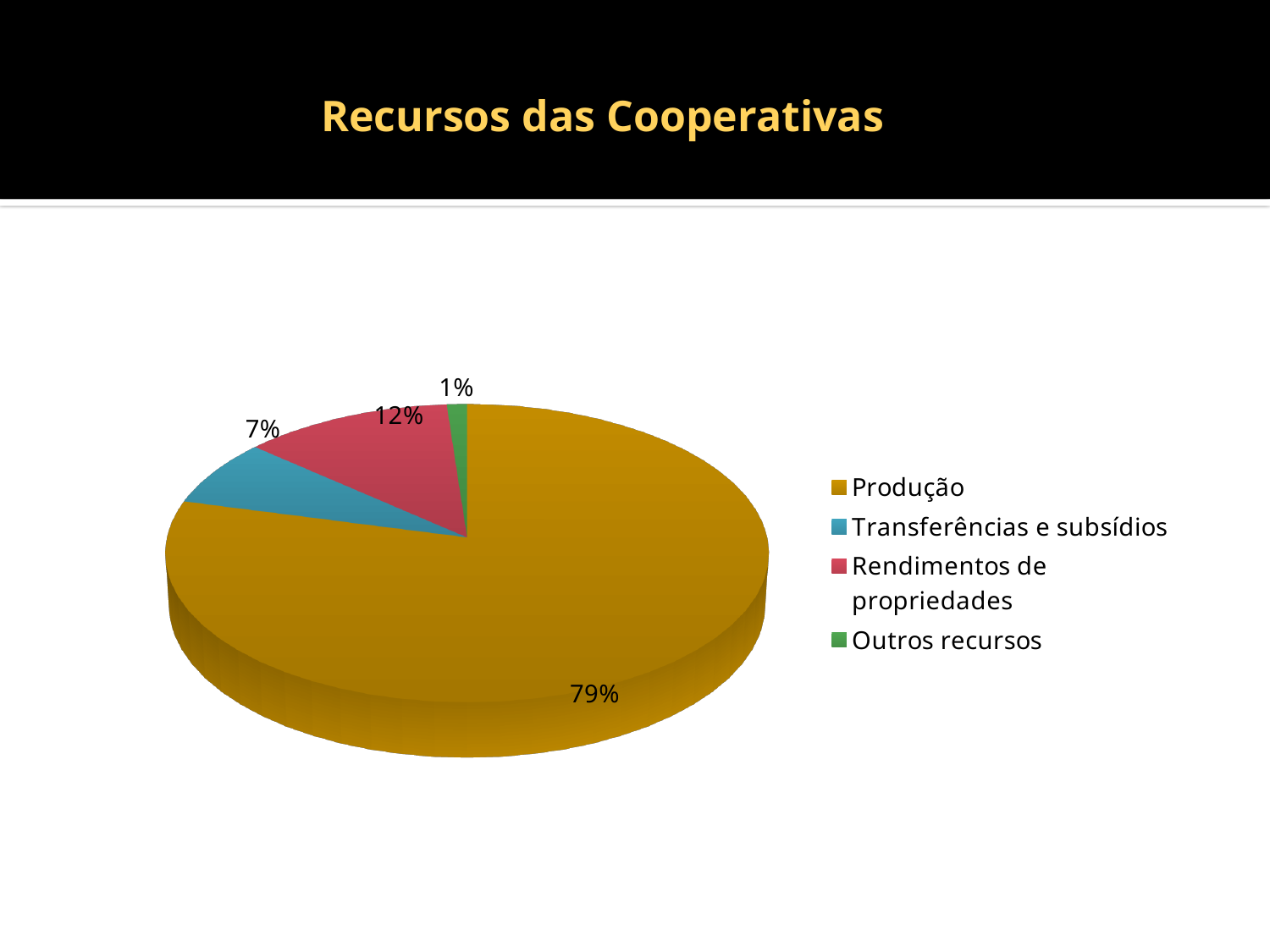
What colour is the slice for Transferências e subsídios? Blue Which is larger, Transferências e subsídios or Rendimentos de propriedades? Rendimentos de propriedades What is the difference in percentage points between Produção and Rendimentos de propriedades? 67 What share of the pie does Produção account for? 79% Which category has the largest slice of the pie? Produção What is the value shown for Transferências e subsídios? 7% What is the title of the slide? Recursos das Cooperativas What is the value shown for Rendimentos de propriedades? 12% What is the value shown for Outros recursos? 1% Which category has the smallest slice of the pie? Outros recursos What kind of chart is shown on the slide? Pie chart How many categories does the pie chart show? 4